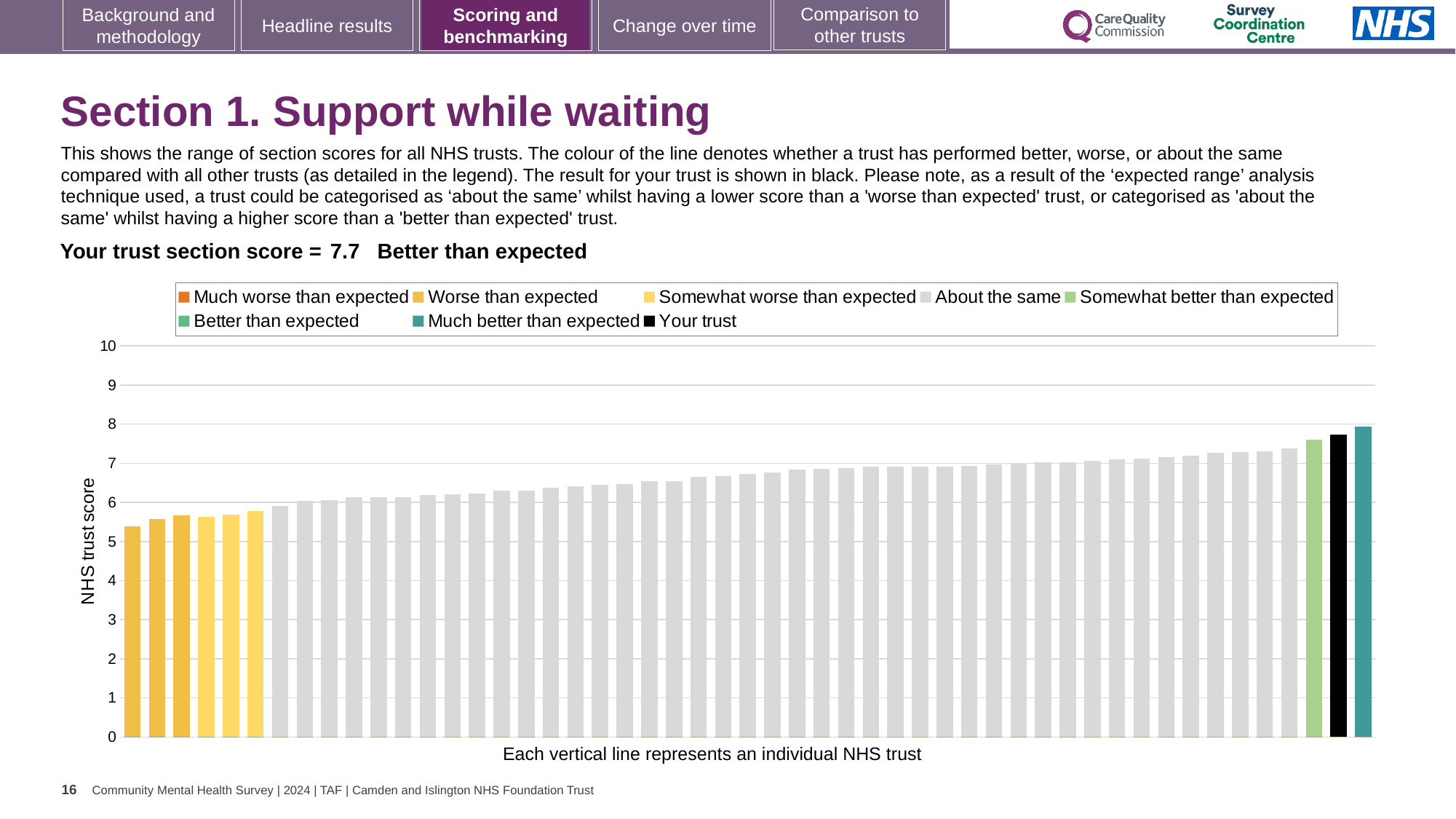
What colour is used for the bar representing your trust? Black What is the section score for your trust shown on the slide? 7.7 What is the label on the vertical axis of the chart? NHS trust score Which is higher: the black bar for your trust or the teal bar to its right? The teal bar Which is higher: the black bar for your trust or the light green bar to its left? The black bar (your trust) What kind of chart is shown on the slide? Bar chart How many entries does the chart legend list? 8 Is the value of the leftmost (lowest) bar greater or less than 6? less How is your trust's section score of 7.7 categorised on the slide? Better than expected Is the value for your trust (the black bar) greater or less than 7? greater Is the value of the rightmost (highest) bar greater or less than 7? greater Do the bar values rise or fall from left to right along the x axis? Rise